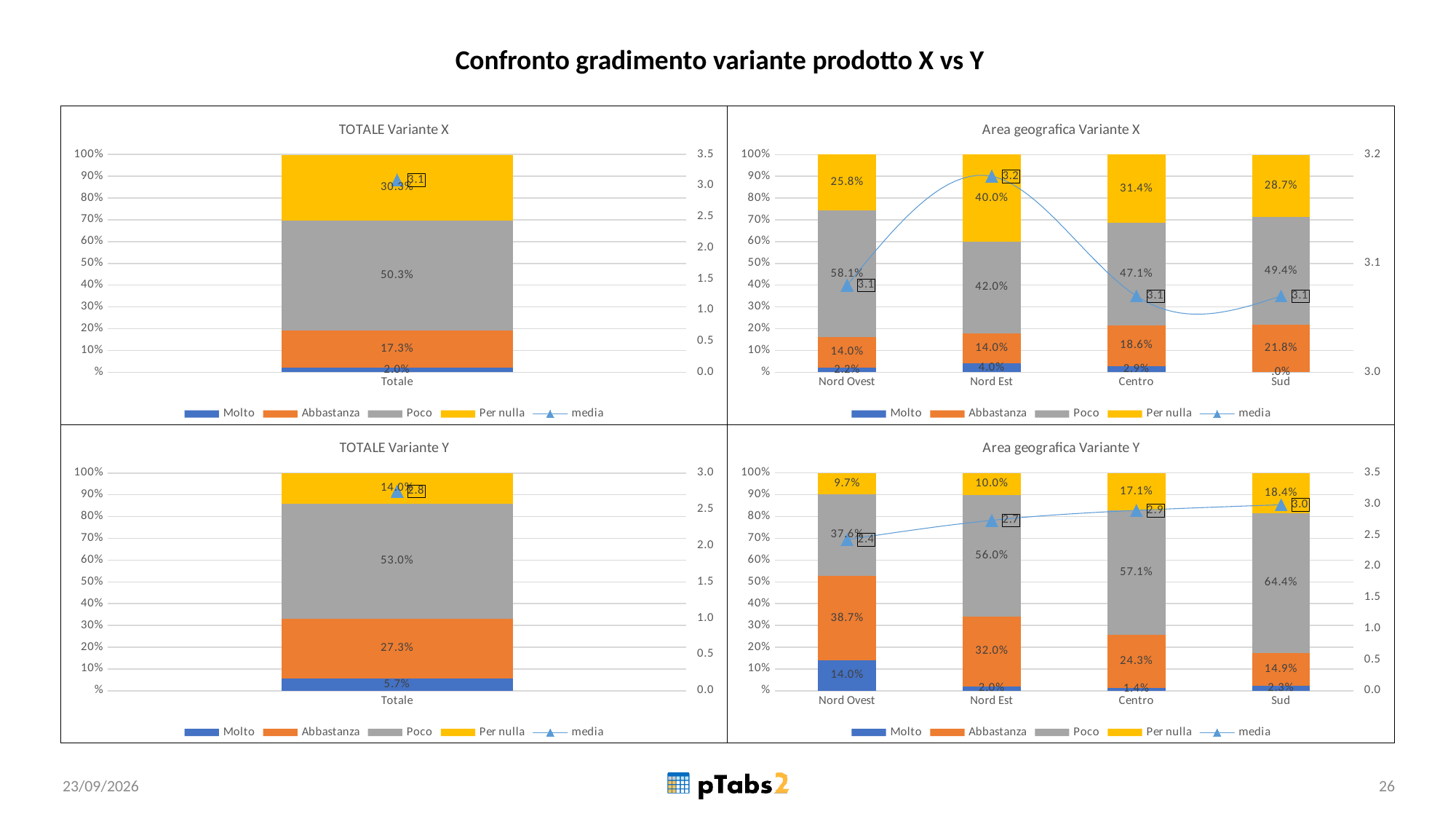
In the 'Area geografica Variante X' chart, which area has the highest media value? Nord Est In the 'Area geografica Variante X' chart, what is the difference between the Abbastanza values for Sud and Nord Ovest? 7.8% In the 'Area geografica Variante Y' chart, does the media line rise or fall from Nord Ovest to Sud? rise In the 'TOTALE Variante Y' chart, what is the media value shown? 2.8 In the 'Area geografica Variante Y' chart, which is larger, the Poco value for Sud or the Poco value for Nord Ovest? Sud In the 'TOTALE Variante X' chart, what is the value for Poco? 50.3% How many areas are shown on the x axis of the 'Area geografica Variante Y' chart? 4 In the 'Area geografica Variante Y' chart, which area has the lowest media value? Nord Ovest In the 'Area geografica Variante X' chart, what is the Per nulla value for Nord Est? 40.0% How many series does the legend of the 'Area geografica Variante X' chart list? 5 In the 'TOTALE Variante Y' chart, what is the value for Abbastanza? 27.3% In the 'TOTALE Variante X' chart, what is the media value shown for Totale? 3.1